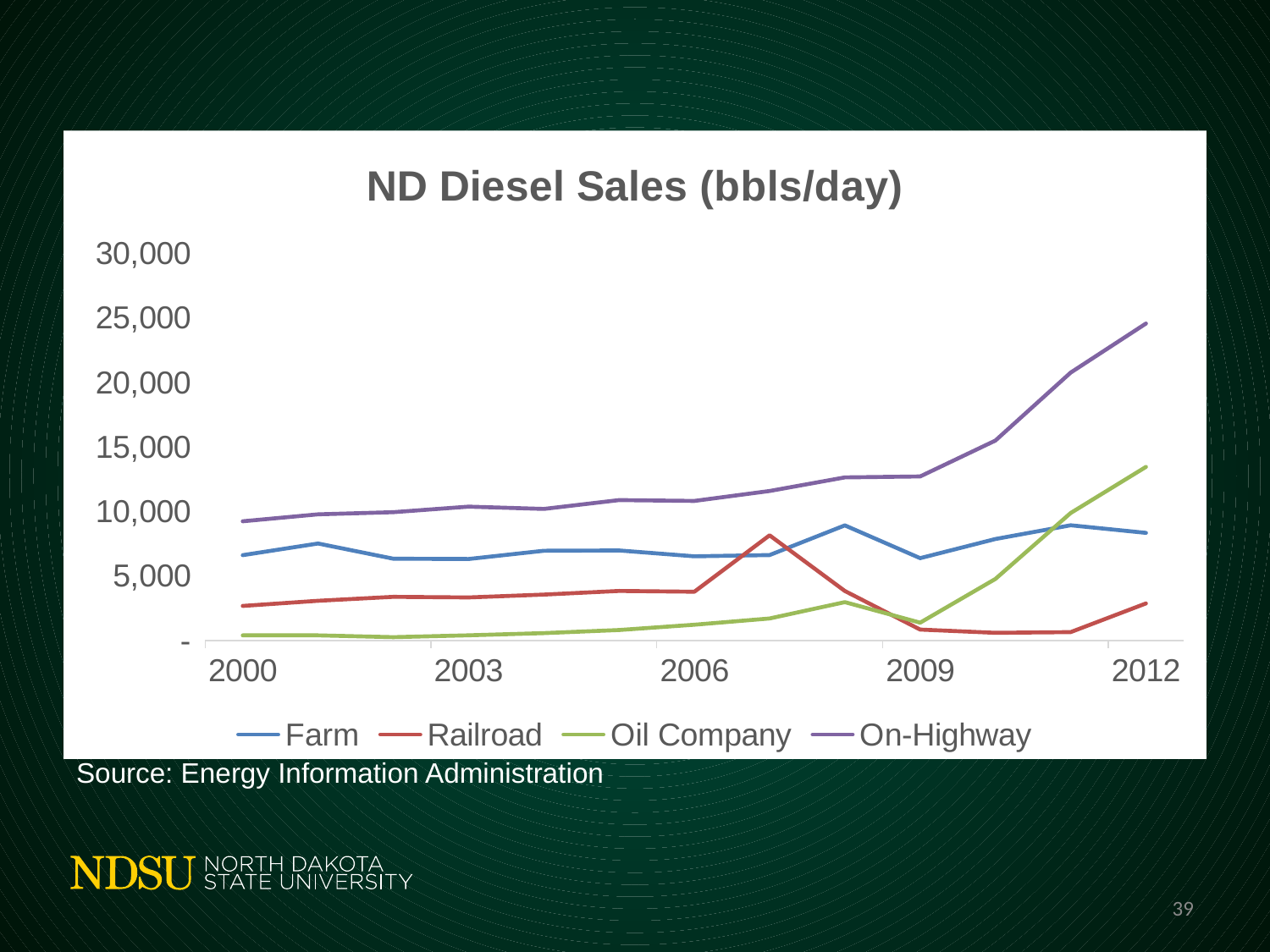
In 2009, which is larger: the Farm value or the Oil Company value? Farm Does the On-Highway series rise or fall from 2000 to 2012? rise Which series has the lowest value in 2000? Oil Company Is the On-Highway value in 2012 greater or less than 20,000? greater Which series has the lowest value in 2012? Railroad Is the Oil Company value in 2012 greater or less than 10,000? greater What is the title of the chart? ND Diesel Sales (bbls/day) How many series does the legend list? 4 What kind of chart is shown on the slide? line chart In 2012, which is larger: the Oil Company value or the Farm value? Oil Company Is the Farm value in 2000 greater or less than 10,000? less Which series has the highest value in 2012? On-Highway